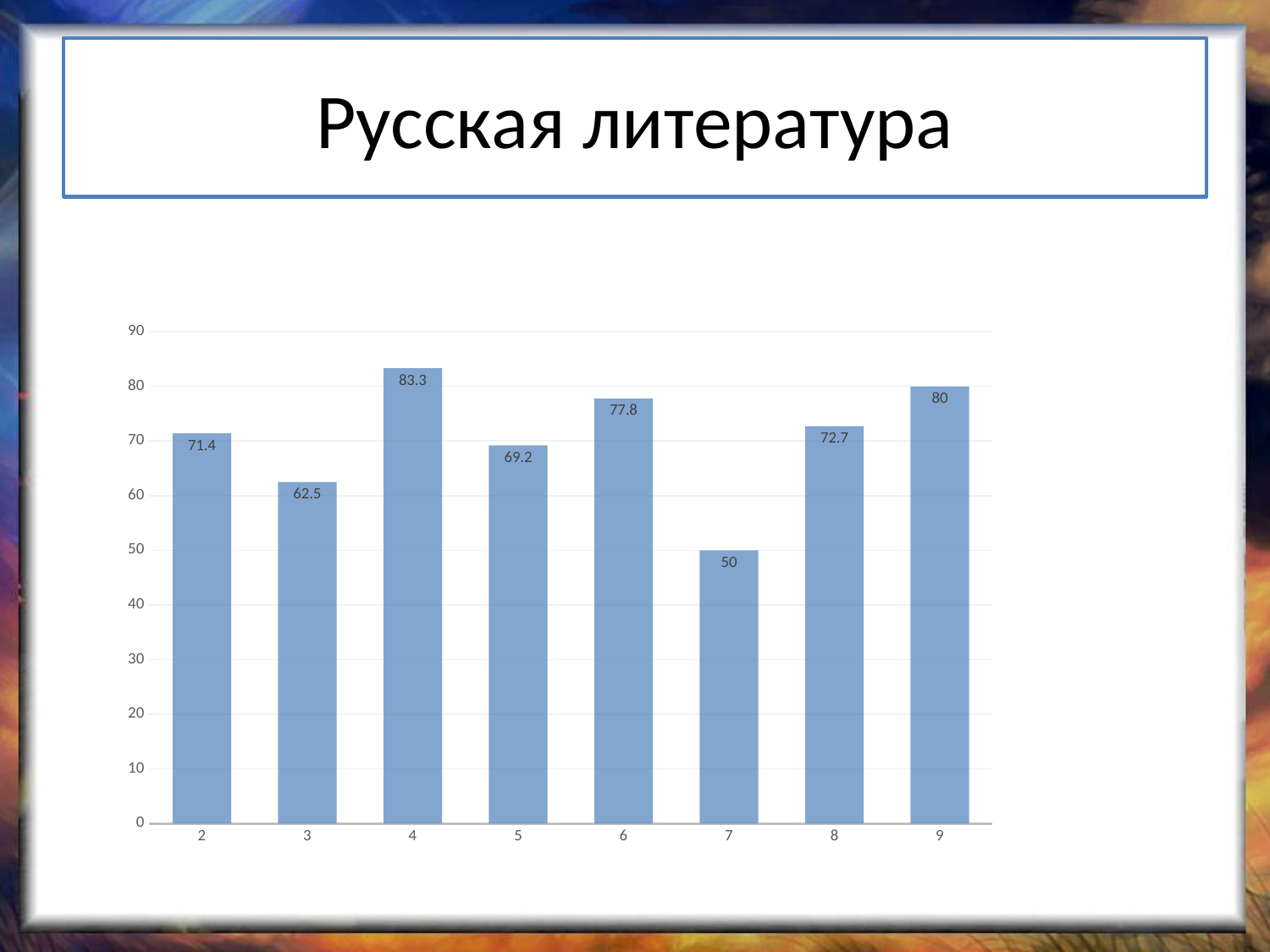
What is the value for category 4? 83.3 What is the value for category 9? 80 Which category has the highest value? 4 How many categories are shown on the x axis? 8 Which category has the lowest value? 7 What is the value for category 3? 62.5 What is the value for category 7? 50 Which is larger, the value for category 6 or the value for category 8? 6 What is the difference between the values for category 4 and category 7? 33.3 Is the value for category 5 greater or less than 70? less What kind of chart is shown on the slide? bar chart What is the title of the slide? Русская литература